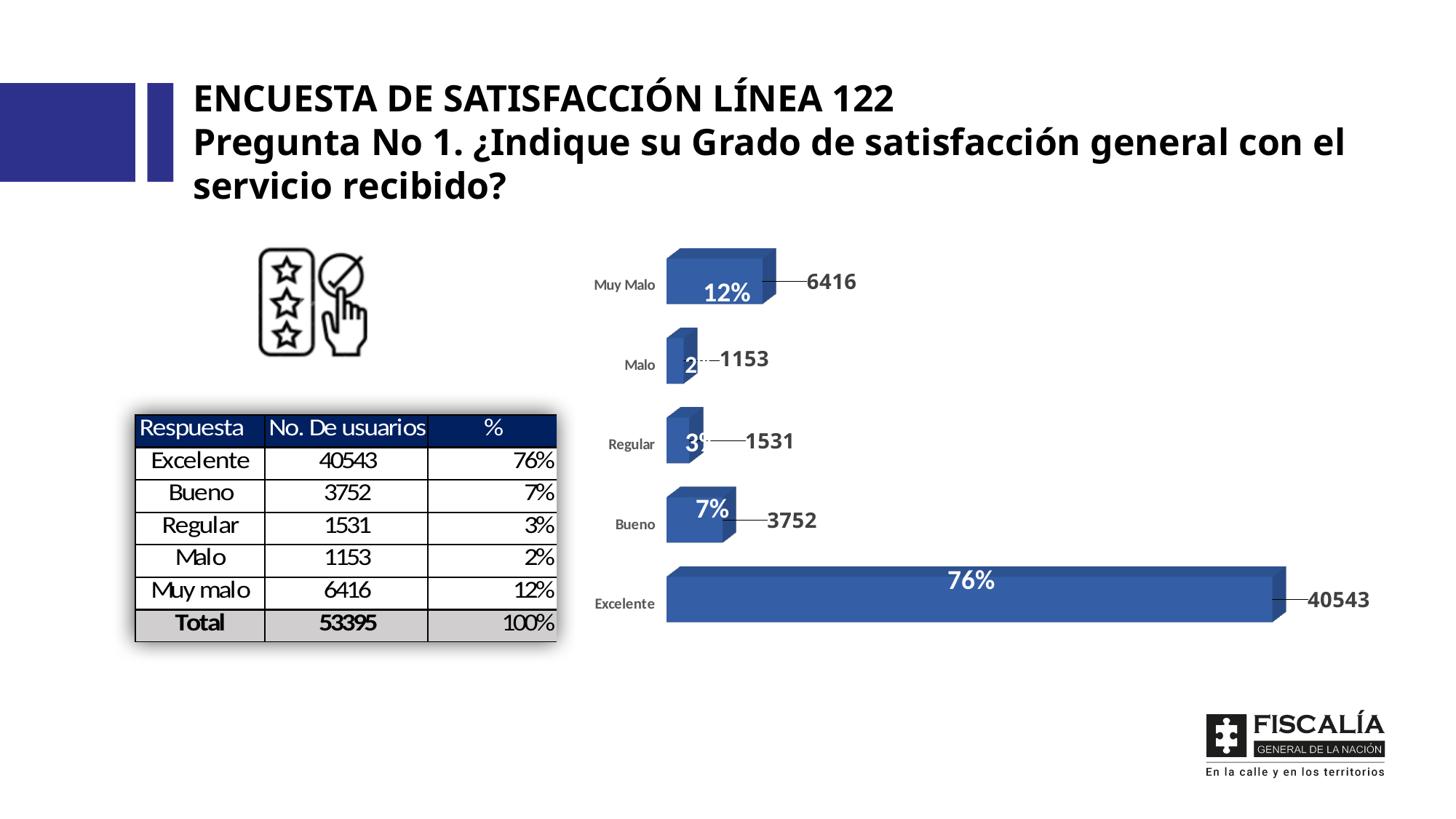
What is the number of users for Excelente in the bar chart? 40543 What kind of chart is shown on the slide? bar chart How many categories are shown in the bar chart? 5 What is the number of users for Bueno in the bar chart? 3752 Which category has the lowest value in the bar chart? Malo What is the number of users for Malo in the bar chart? 1153 What is the difference between the values for Muy Malo and Malo in the bar chart? 5263 Which is larger in the bar chart, the value for Regular or the value for Malo? Regular What is the difference between the values for Excelente and Bueno in the bar chart? 36791 What is the number of users for Muy Malo in the bar chart? 6416 Which category has the highest value in the bar chart? Excelente What is the number of users for Regular in the bar chart? 1531